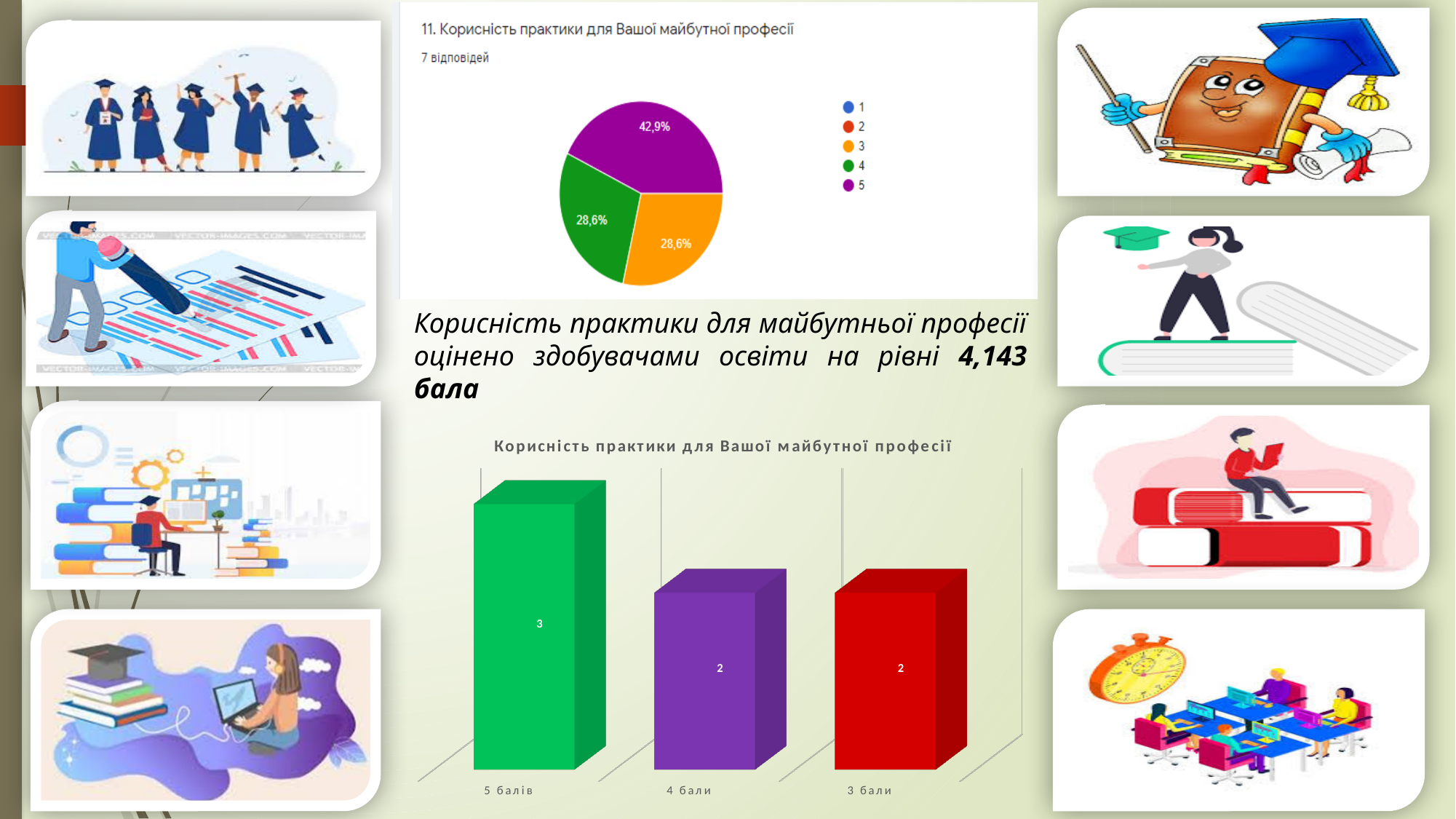
In the pie chart at the top, what share does the purple slice (5) have? 42,9% In the bar chart at the bottom, what is the difference between the values for "5 балів" and "4 бали"? 1 What kind of chart is the chart at the bottom of the slide? bar chart In the bar chart at the bottom, what is the value for "5 балів"? 3 How many responses does the pie chart at the top report? 7 відповідей In the bar chart at the bottom, what is the value for "4 бали"? 2 In the bar chart at the bottom, how many categories are shown? 3 In the pie chart at the top, what share does the green slice (4) have? 28,6% In the bar chart at the bottom, which category has the highest value? 5 балів In the pie chart at the top, how many entries does the legend list? 5 In the bar chart at the bottom, what is the value for "3 бали"? 2 In the pie chart at the top, which slice is the largest? 5